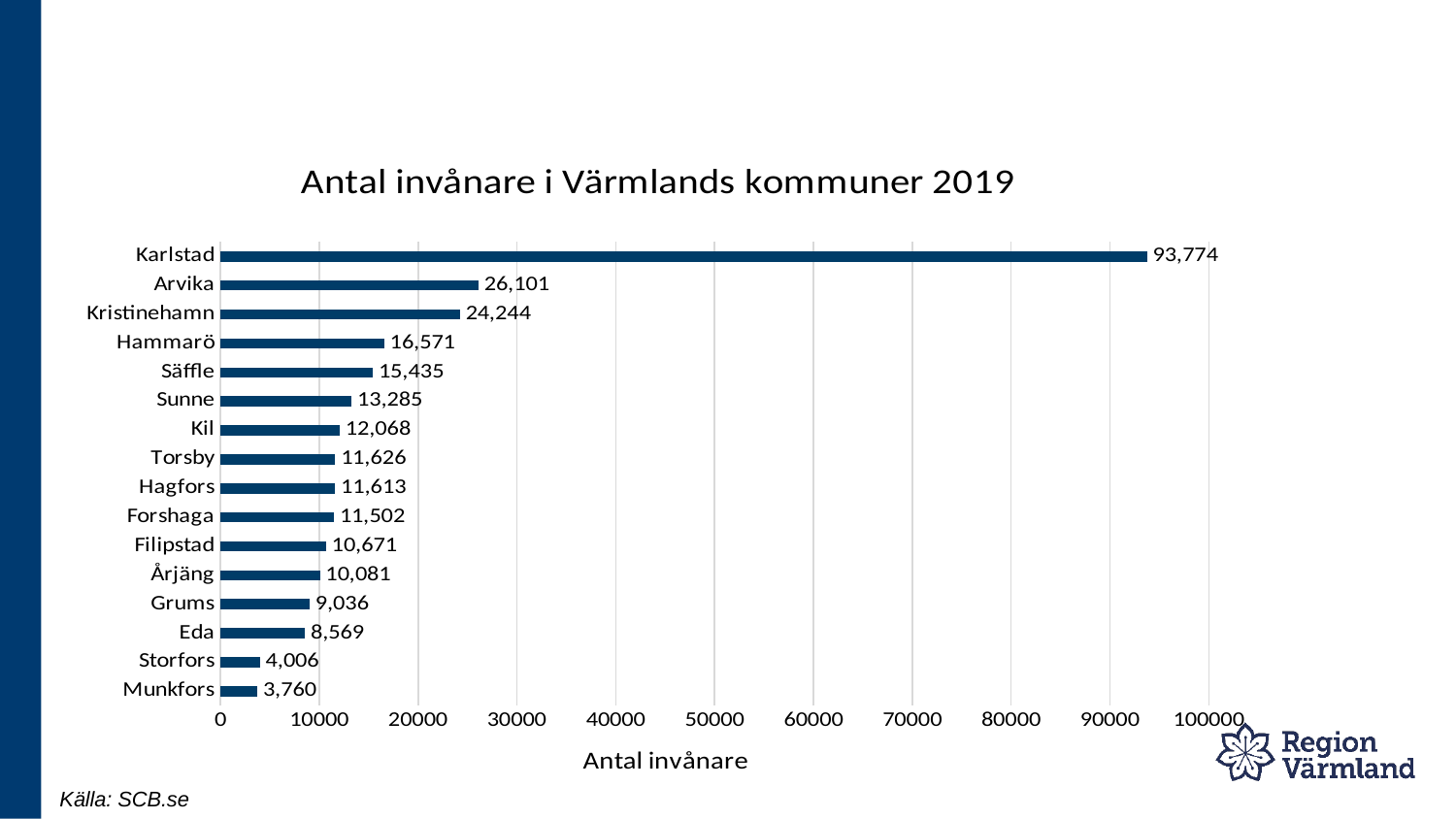
Which municipality has the highest number of inhabitants? Karlstad What is the number of inhabitants shown for Karlstad? 93,774 What is the difference between the values for Storfors and Munkfors? 246 What is the difference between the values for Karlstad and Arvika? 67,673 Which municipality has the lowest number of inhabitants? Munkfors Which has more inhabitants, Sunne or Kil? Sunne Is the value for Arvika greater or less than 30000? less What is the value shown for Kristinehamn? 24,244 What is the value shown for Munkfors? 3,760 How many municipalities are shown in the chart? 16 What kind of chart is shown on the slide? Bar chart What is the value shown for Årjäng? 10,081